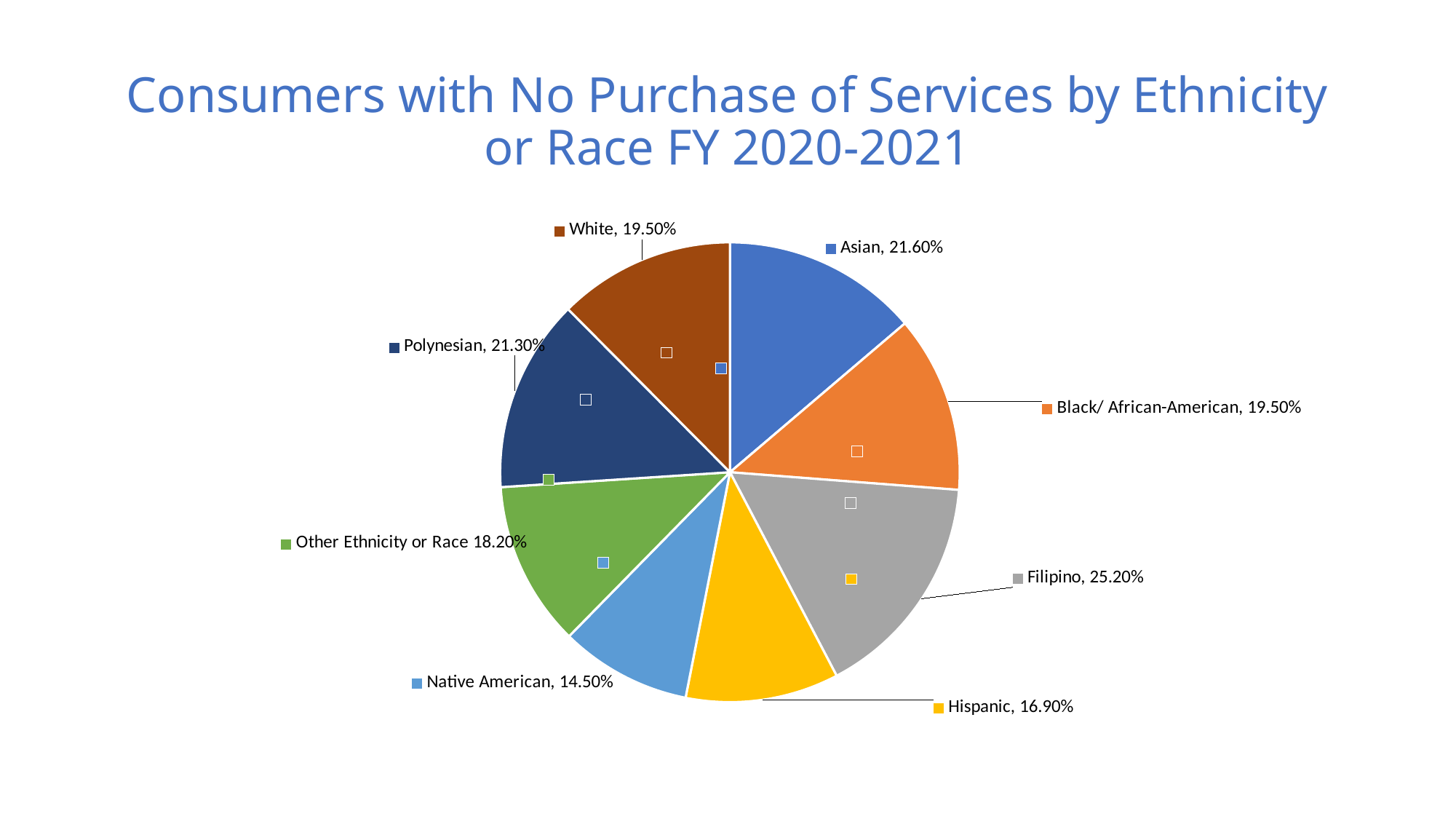
Which category has the largest slice of the pie? Filipino What is the title of the chart? Consumers with No Purchase of Services by Ethnicity or Race FY 2020-2021 What percentage is shown for Polynesian? 21.30% What percentage is shown for Filipino? 25.20% What percentage is shown for Other Ethnicity or Race? 18.20% How many ethnicity or race categories are shown in the pie chart? 8 What is the difference in percentage points between Filipino and Native American? 10.70 percentage points What percentage is shown for Native American? 14.50% Which two categories share the same value of 19.50%? White and Black/ African-American Which category has the smallest slice of the pie? Native American What type of chart is shown on the slide? Pie chart Which is larger, the value for Hispanic or the value for White? White